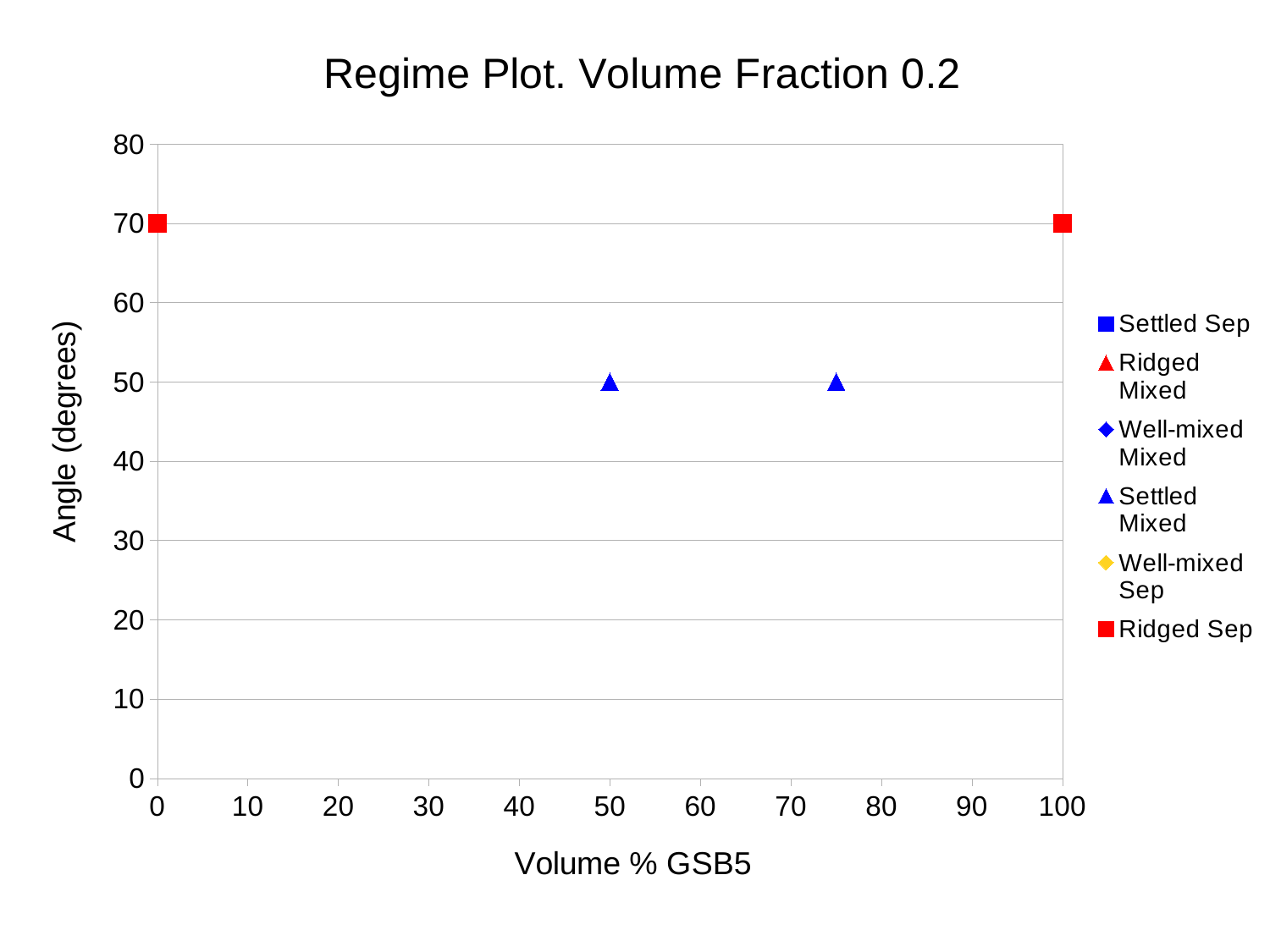
What is the angle (degrees) of the Settled Mixed point at Volume % GSB5 = 50? 50 Is the angle of the Settled Mixed point near Volume % GSB5 = 75 greater or less than 60? less What is the title of the chart? Regime Plot. Volume Fraction 0.2 What is the Volume % GSB5 of the rightmost Ridged Sep point? 100 What is the difference in angle (degrees) between the Ridged Sep points and the Settled Mixed points? 20 Which series is plotted at a higher angle, Ridged Sep or Settled Mixed? Ridged Sep What is the angle (degrees) of the Ridged Sep point at Volume % GSB5 = 0? 70 How many Ridged Sep (red square) points are plotted? 2 What kind of chart is shown on the slide? scatter chart What is the label of the x axis? Volume % GSB5 How many series does the legend list? 6 How many data points are plotted on the chart? 4